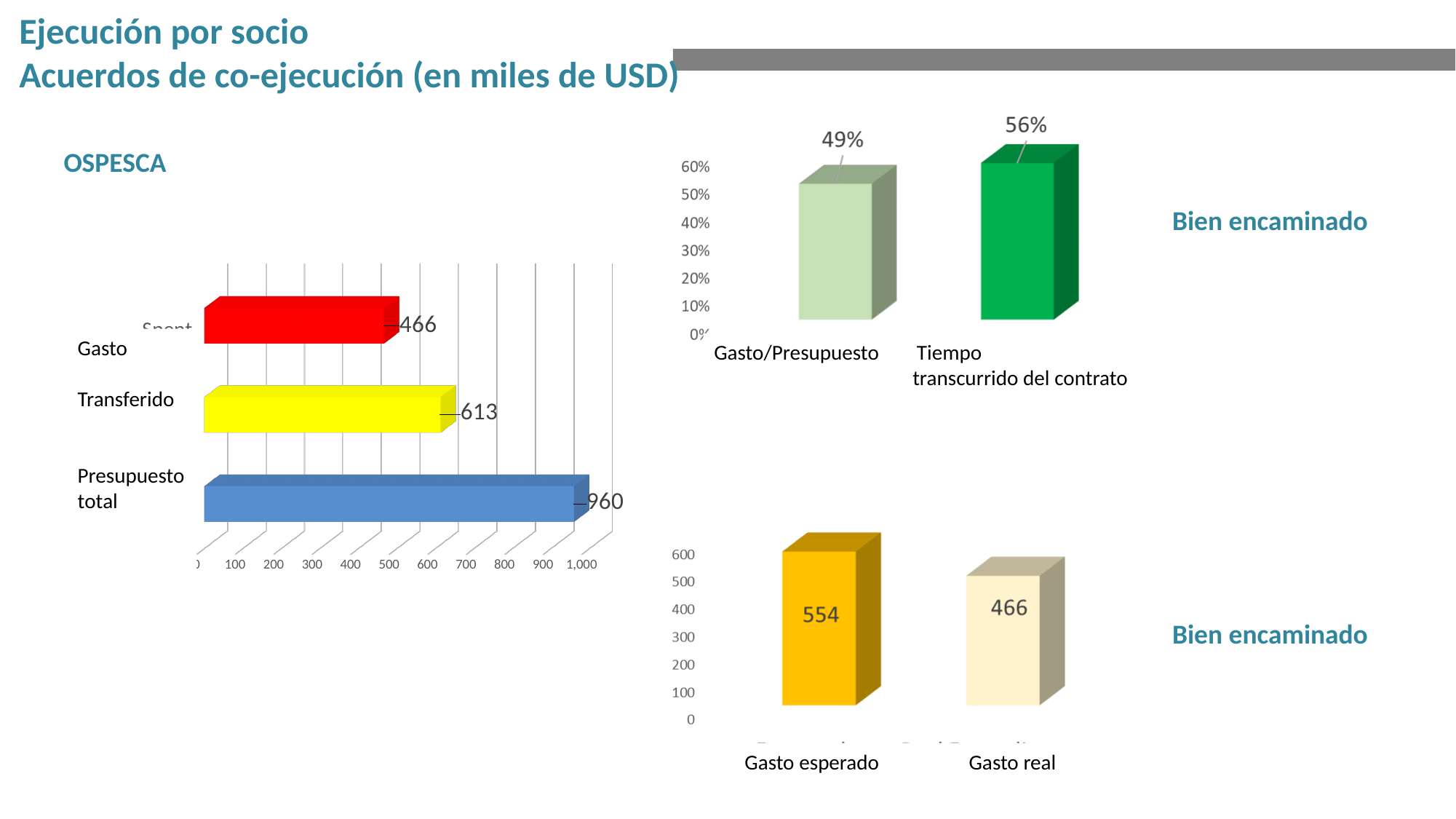
In the OSPESCA bar chart on the left, what is the value for Transferido? 613 In the bottom-right chart, what is the difference between Gasto esperado and Gasto real? 88 In the OSPESCA bar chart on the left, what is the value for Presupuesto total? 960 In the top-right chart, what is the value for Tiempo transcurrido del contrato? 56% In the OSPESCA bar chart on the left, which category has the highest value? Presupuesto total In the top-right chart, what is the value for Gasto/Presupuesto? 49% In the OSPESCA bar chart on the left, which category has the lowest value? Gasto In the OSPESCA bar chart on the left, what is the difference between Presupuesto total and Transferido? 347 In the OSPESCA bar chart on the left, what is the value for Gasto? 466 What kind of chart is the OSPESCA chart on the left? Bar chart In the bottom-right chart, what is the value for Gasto esperado? 554 In the OSPESCA bar chart on the left, how many categories are shown? 3